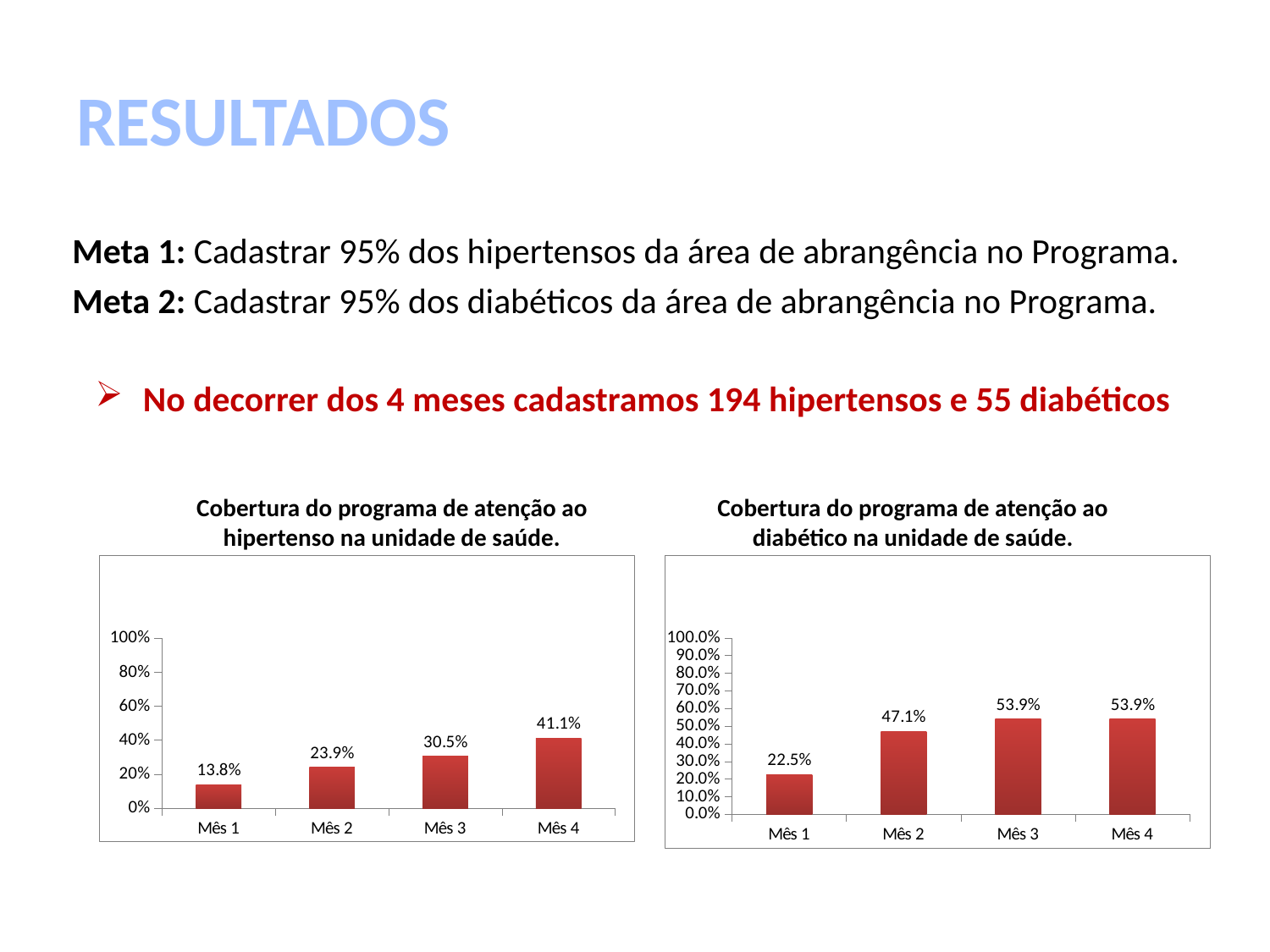
In the left chart (hipertenso), which month has the highest value? Mês 4 In the right chart (diabético), which is larger: the value for Mês 2 or the value for Mês 3? Mês 3 How many months are shown on the x axis of the left chart (hipertenso)? 4 In the right chart (diabético), what is the difference between the values for Mês 2 and Mês 1? 24.6% In the right chart (diabético), which month has the lowest value? Mês 1 In the right chart (Cobertura do programa de atenção ao diabético na unidade de saúde), what is the value for Mês 1? 22.5% In the left chart (Cobertura do programa de atenção ao hipertenso na unidade de saúde), what is the value for Mês 3? 30.5% In the left chart (hipertenso), do the values rise or fall from Mês 1 to Mês 4? rise What is the title of the right chart? Cobertura do programa de atenção ao diabético na unidade de saúde. In the left chart (hipertenso), what is the difference between the values for Mês 4 and Mês 1? 27.3% What kind of chart is the right chart (diabético)? bar chart In the left chart (hipertenso), is the value for Mês 4 greater or less than 60%? less